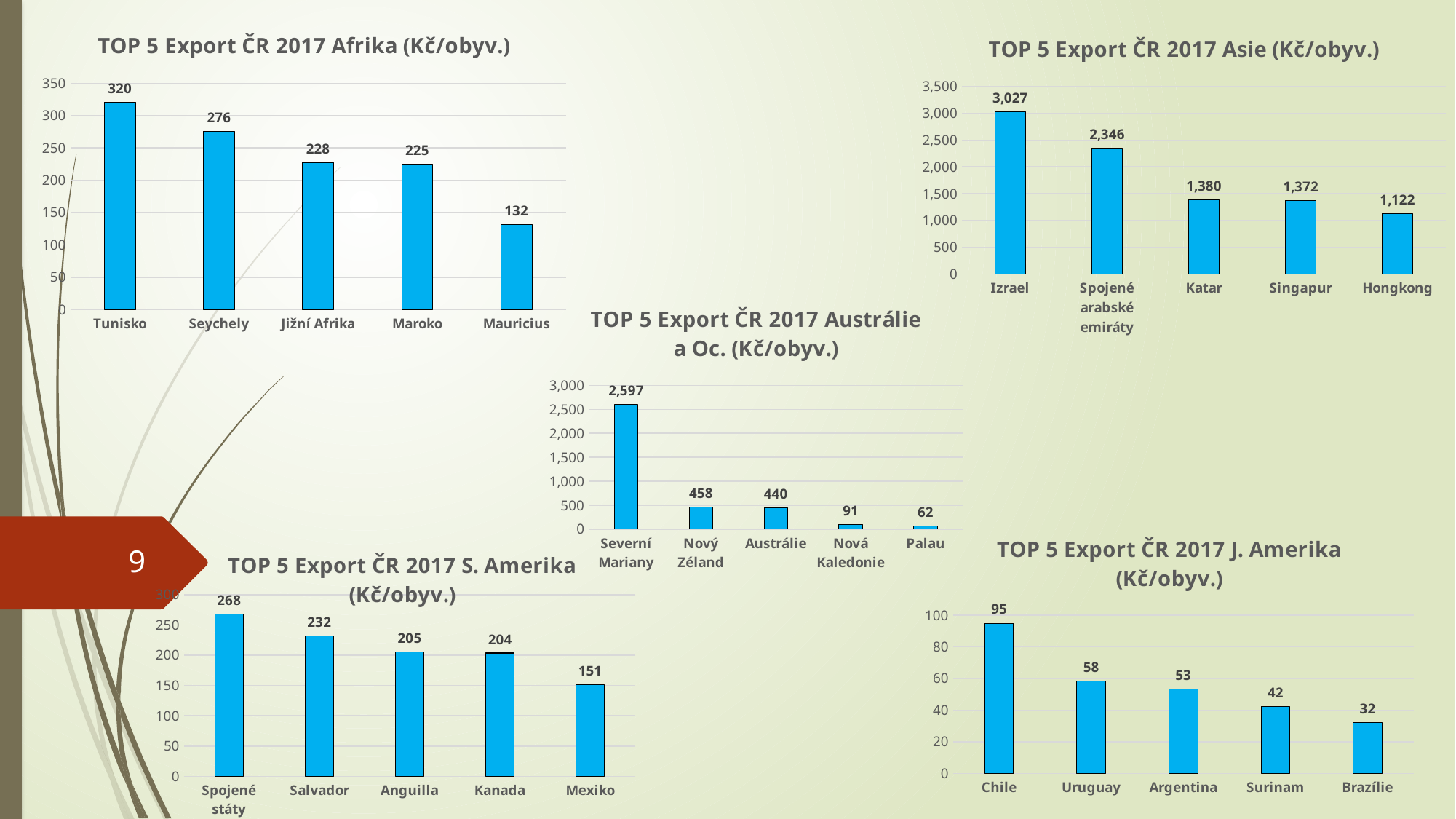
In the chart titled "TOP 5 Export ČR 2017 S. Amerika (Kč/obyv.)", which is larger, Spojené státy or Mexiko? Spojené státy What kind of chart is the one titled "TOP 5 Export ČR 2017 Asie (Kč/obyv.)"? Bar chart In the chart titled "TOP 5 Export ČR 2017 Asie (Kč/obyv.)", which country has the highest value? Izrael In the chart titled "TOP 5 Export ČR 2017 S. Amerika (Kč/obyv.)", what is the value for Kanada? 204 In the chart titled "TOP 5 Export ČR 2017 Asie (Kč/obyv.)", what is the value for Singapur? 1,372 In the chart titled "TOP 5 Export ČR 2017 Afrika (Kč/obyv.)", do the values rise or fall from left to right? Fall In the chart titled "TOP 5 Export ČR 2017 Afrika (Kč/obyv.)", what is the value for Seychely? 276 How many categories are shown in the chart titled "TOP 5 Export ČR 2017 Afrika (Kč/obyv.)"? 5 In the chart titled "TOP 5 Export ČR 2017 J. Amerika (Kč/obyv.)", what is the value for Surinam? 42 In the chart titled "TOP 5 Export ČR 2017 Austrálie a Oc. (Kč/obyv.)", which category has the lowest value? Palau In the chart titled "TOP 5 Export ČR 2017 Austrálie a Oc. (Kč/obyv.)", what is the difference between Severní Mariany and Nový Zéland? 2,139 In the chart titled "TOP 5 Export ČR 2017 J. Amerika (Kč/obyv.)", what is the difference between Chile and Brazílie? 63